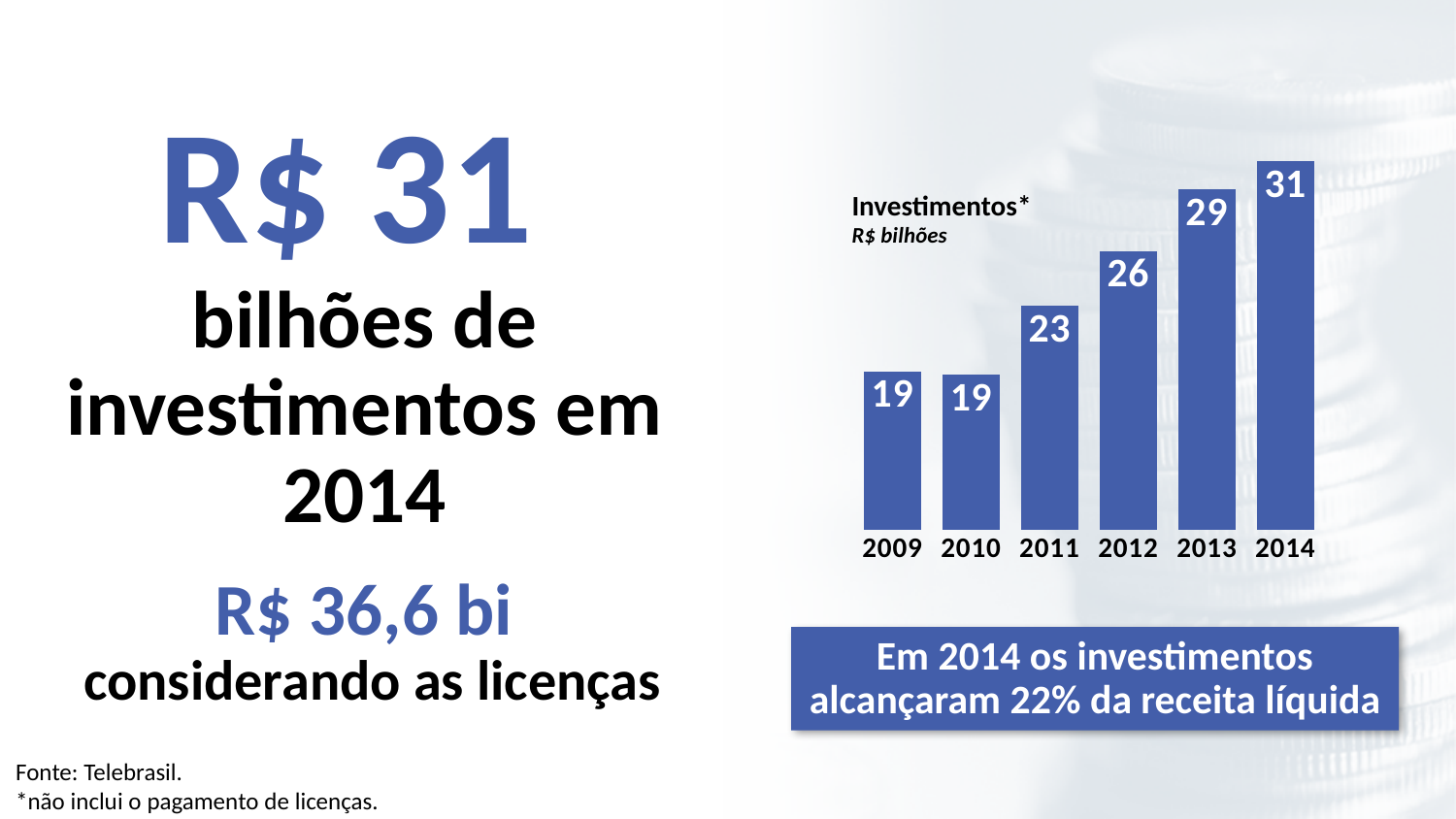
What is the value for 2013 in the Investimentos chart? 29 What kind of chart is the Investimentos chart? bar chart What is the value for 2009 in the Investimentos chart? 19 Which two years have the same value in the Investimentos chart? 2009 and 2010 Do the values in the Investimentos chart rise or fall from 2009 to 2014? rise What is the difference between the values for 2014 and 2009 in the Investimentos chart? 12 What is the value for 2011 in the Investimentos chart? 23 How many years are shown in the Investimentos chart? 6 Which year has the highest value in the Investimentos chart? 2014 Which is larger in the Investimentos chart, the value for 2012 or the value for 2013? 2013 What is the difference between the values for 2012 and 2011 in the Investimentos chart? 3 What unit is given under the title of the Investimentos chart? R$ bilhões